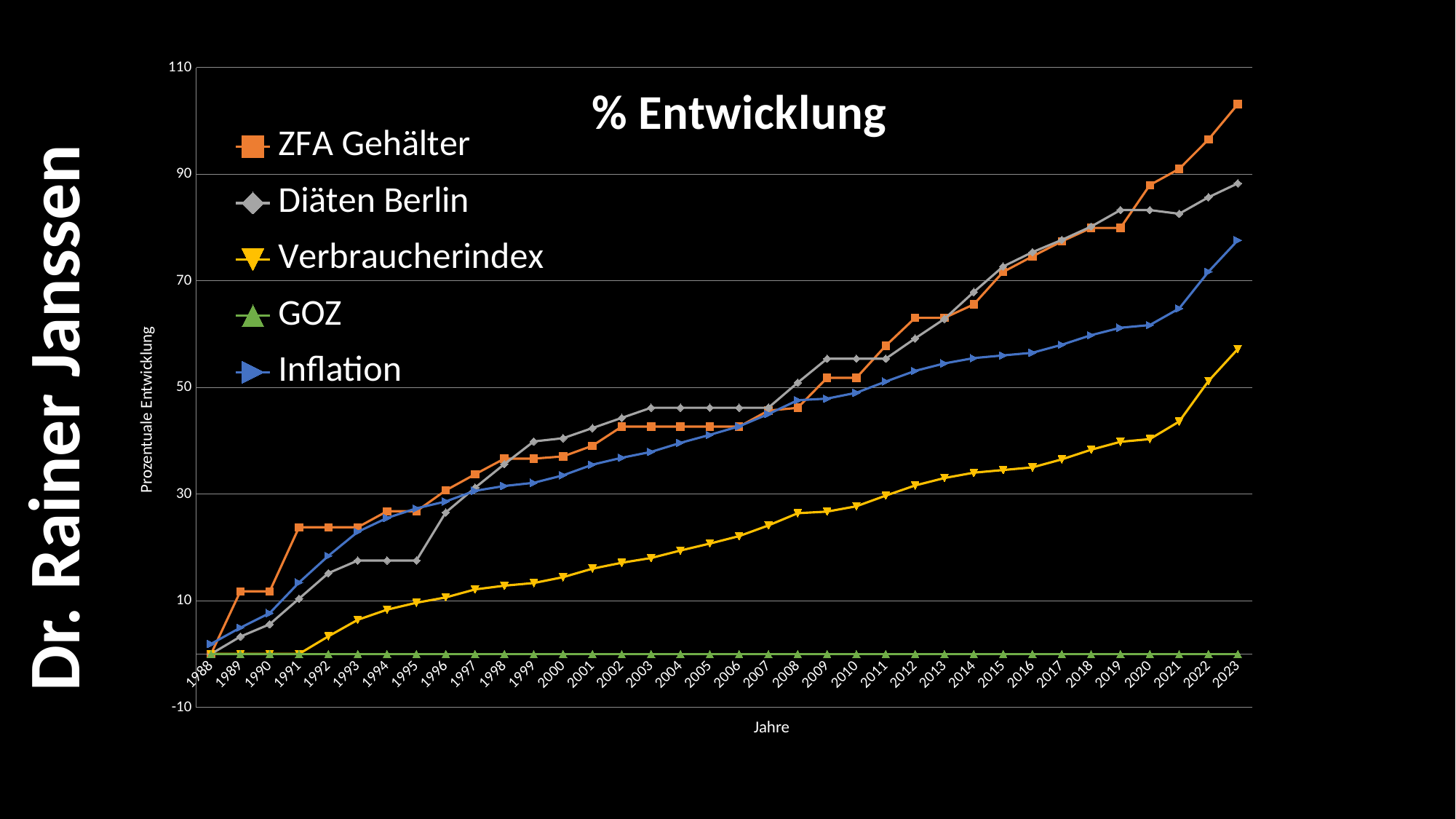
Is the value for Verbraucherindex in 2000 greater or less than 30? less In 2023, which is larger: Inflation or Verbraucherindex? Inflation Is the value for ZFA Gehälter in 2023 greater or less than 90? greater How many series does the legend list? 5 How many years are plotted along the x axis? 36 Does the ZFA Gehälter series rise or fall from 1988 to 2023? rise Is the value for Verbraucherindex in 2023 greater or less than 50? greater What is the title of the chart? % Entwicklung What kind of chart is shown on the slide? line chart Which series has the highest value in 2023? ZFA Gehälter Which series has the lowest value in 2023? GOZ